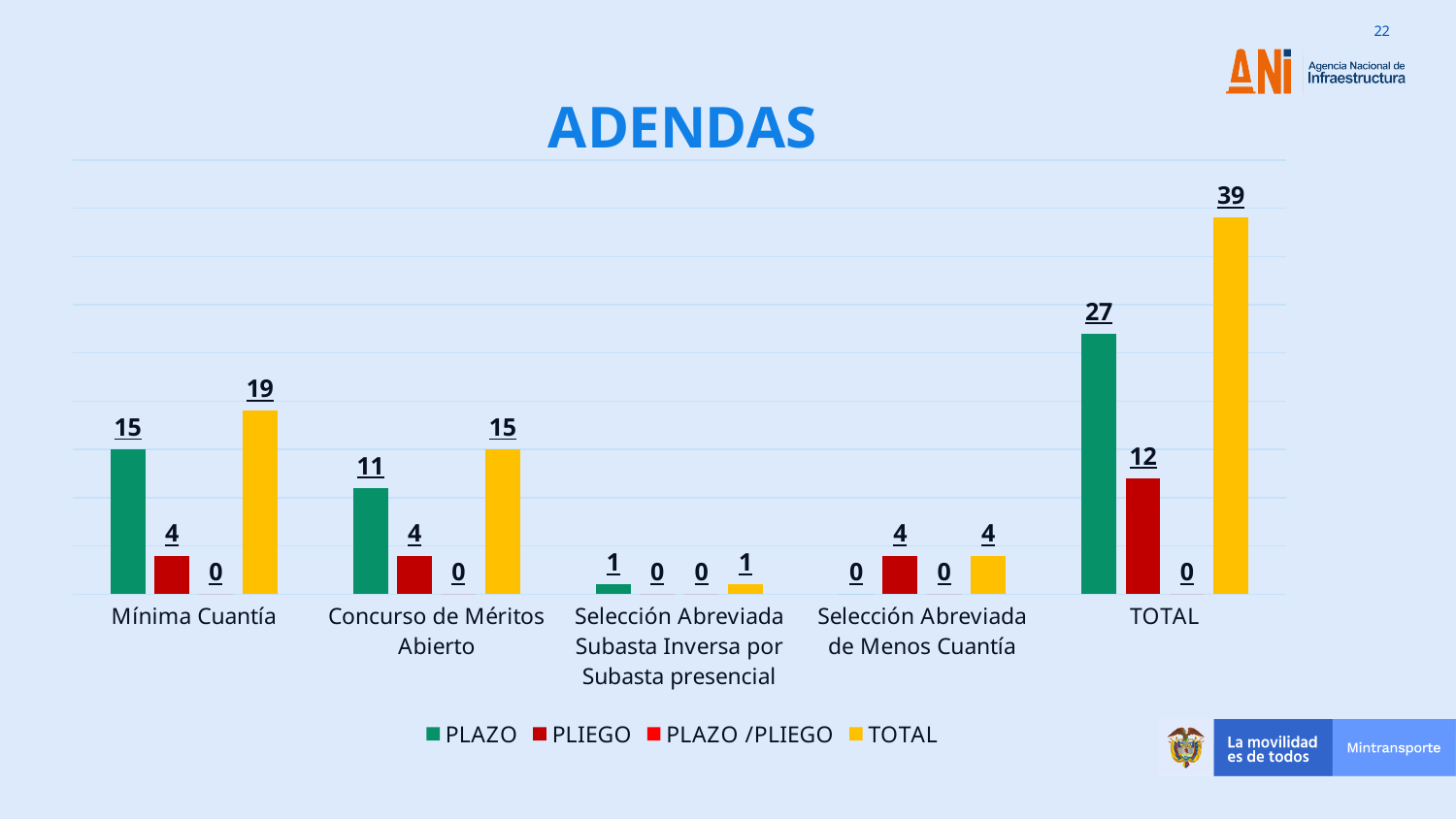
What is the difference between the PLAZO values for Mínima Cuantía and Concurso de Méritos Abierto? 4 What kind of chart is shown on the slide? Bar chart What is the PLIEGO value for the TOTAL category? 12 Which category has the highest TOTAL value? TOTAL What is the title of the chart? ADENDAS What is the TOTAL value for Mínima Cuantía? 19 How many categories are shown on the x axis? 5 Which is larger, the PLAZO value for Mínima Cuantía or the PLIEGO value for Selección Abreviada de Menos Cuantía? PLAZO value for Mínima Cuantía What is the PLAZO value for Selección Abreviada Subasta Inversa por Subasta presencial? 1 How many series does the legend list? 4 Excluding the TOTAL category, which category has the lowest TOTAL value? Selección Abreviada Subasta Inversa por Subasta presencial What is the PLAZO value for Concurso de Méritos Abierto? 11